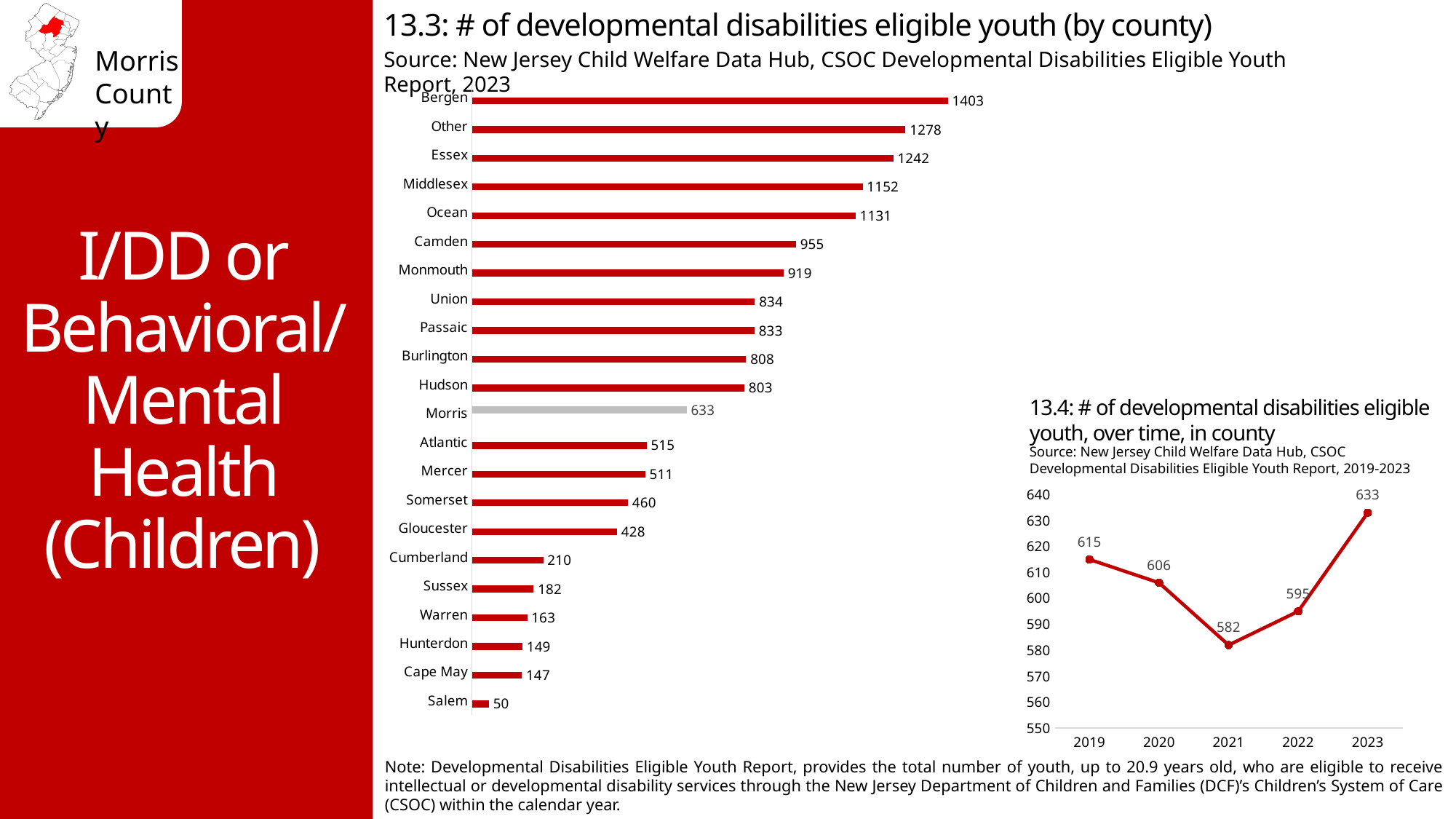
In chart 13.3 (by county), which county has the lowest number of developmental disabilities eligible youth? Salem In chart 13.4 (over time, in county), what is the difference between the 2023 and 2022 values? 38 In chart 13.3 (by county), what is the value for Hunterdon? 149 What type of chart is chart 13.4 (# of developmental disabilities eligible youth over time, in county)? Line chart In chart 13.3 (by county), what is the difference between the values for Bergen and Morris? 770 In chart 13.3 (by county), which county has the highest number of developmental disabilities eligible youth? Bergen What type of chart is chart 13.3 (# of developmental disabilities eligible youth by county)? Bar chart In chart 13.3 (# of developmental disabilities eligible youth by county), what is the value for Morris? 633 In chart 13.4 (over time, in county), which year has the highest value? 2023 In chart 13.3 (by county), how many bars (categories) are shown? 22 In chart 13.4 (over time, in county), what is the value for 2021? 582 In chart 13.3 (by county), which has a larger value, Camden or Monmouth? Camden